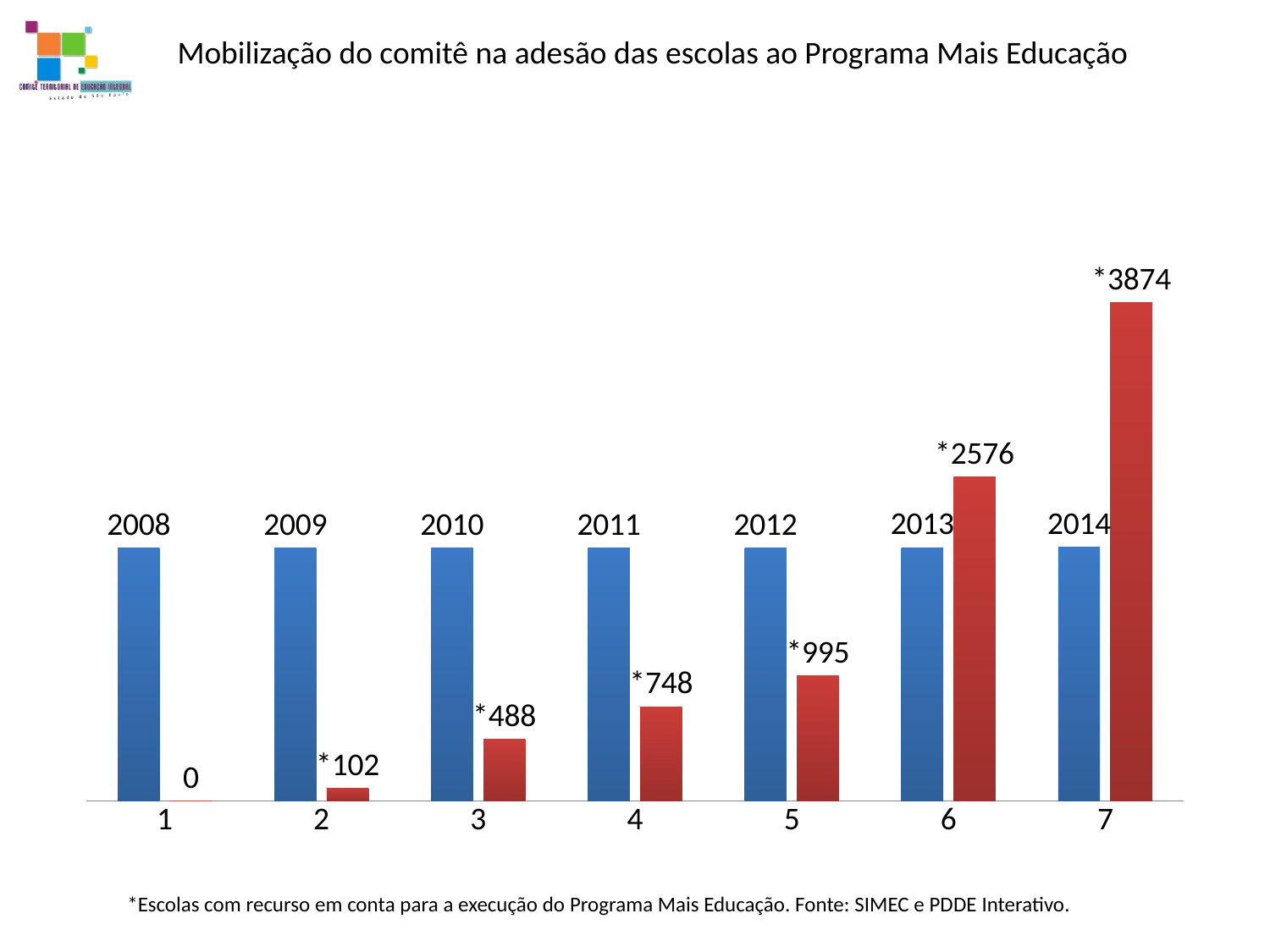
What is the value of the red bar for 2014? *3874 What is the value of the red bar for 2012? *995 Which year has the highest red bar value? 2014 What is the value of the red bar for 2010? *488 What is the value of the red bar for 2008? 0 Do the red bar values rise or fall from 2008 to 2014? rise Which has a larger red bar value, 2011 or 2013? 2013 What is the difference between the red bar values for 2014 and 2013? 1298 Which year has the lowest red bar value? 2008 What is the difference between the red bar values for 2012 and 2011? 247 What type of chart is shown on the slide? bar chart How many categories are shown on the x axis? 7